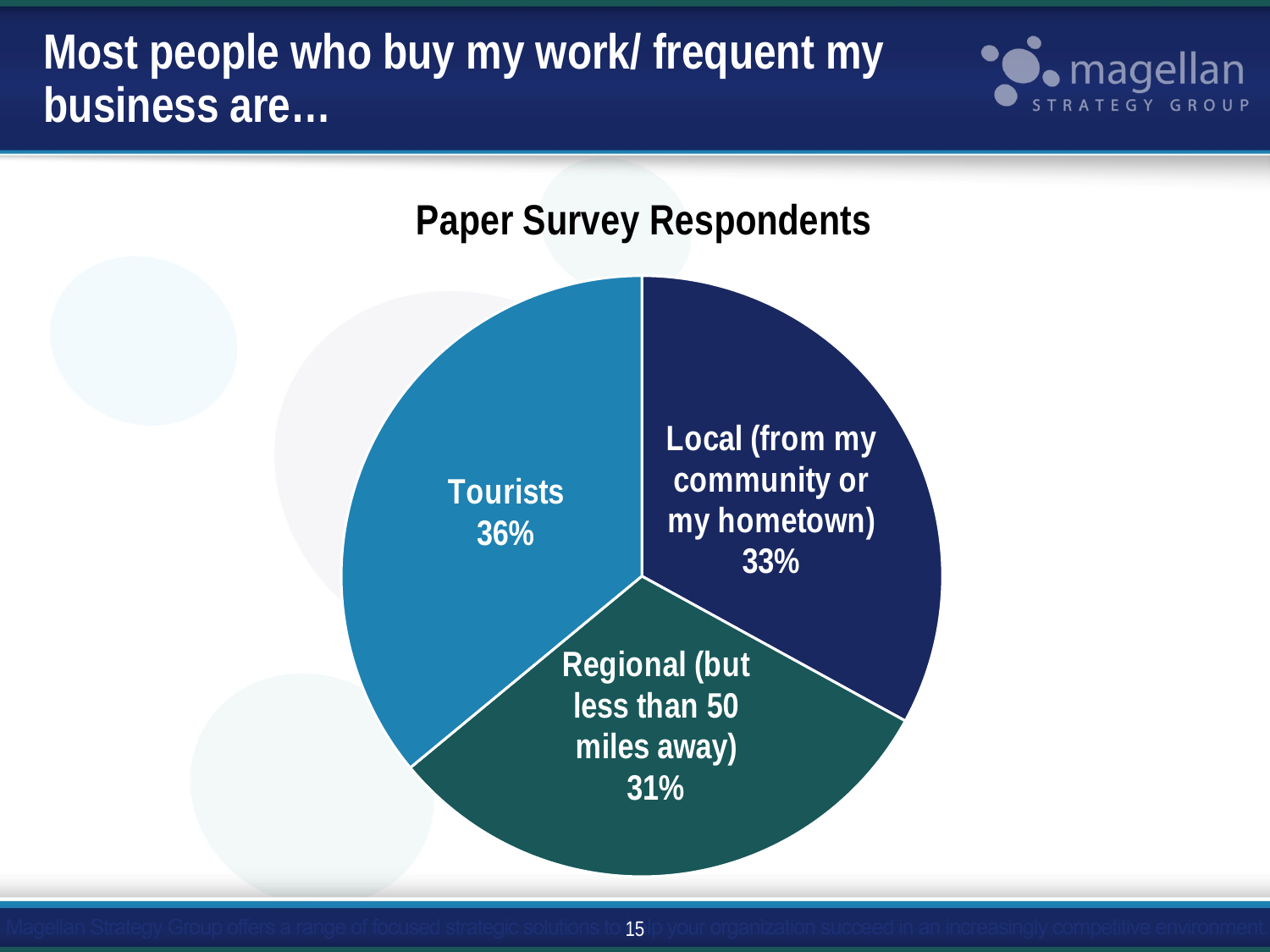
Which is larger, the Tourists slice or the Local slice? Tourists What is the difference in percentage points between the Tourists slice and the Regional slice? 5 Which category has the smallest share of the pie? Regional (but less than 50 miles away) What is the title of the chart? Paper Survey Respondents What percentage of respondents said most of their customers are Regional (but less than 50 miles away)? 31% What percentage of respondents said most of their customers are Local (from my community or my hometown)? 33% How many slices does the pie chart have? 3 What colour is the Tourists slice? Light blue What share of paper survey respondents said most of their customers are Tourists? 36% Which category has the largest share of the pie? Tourists What kind of chart is shown on the slide? Pie chart What is the difference in percentage points between the Local slice and the Regional slice? 2